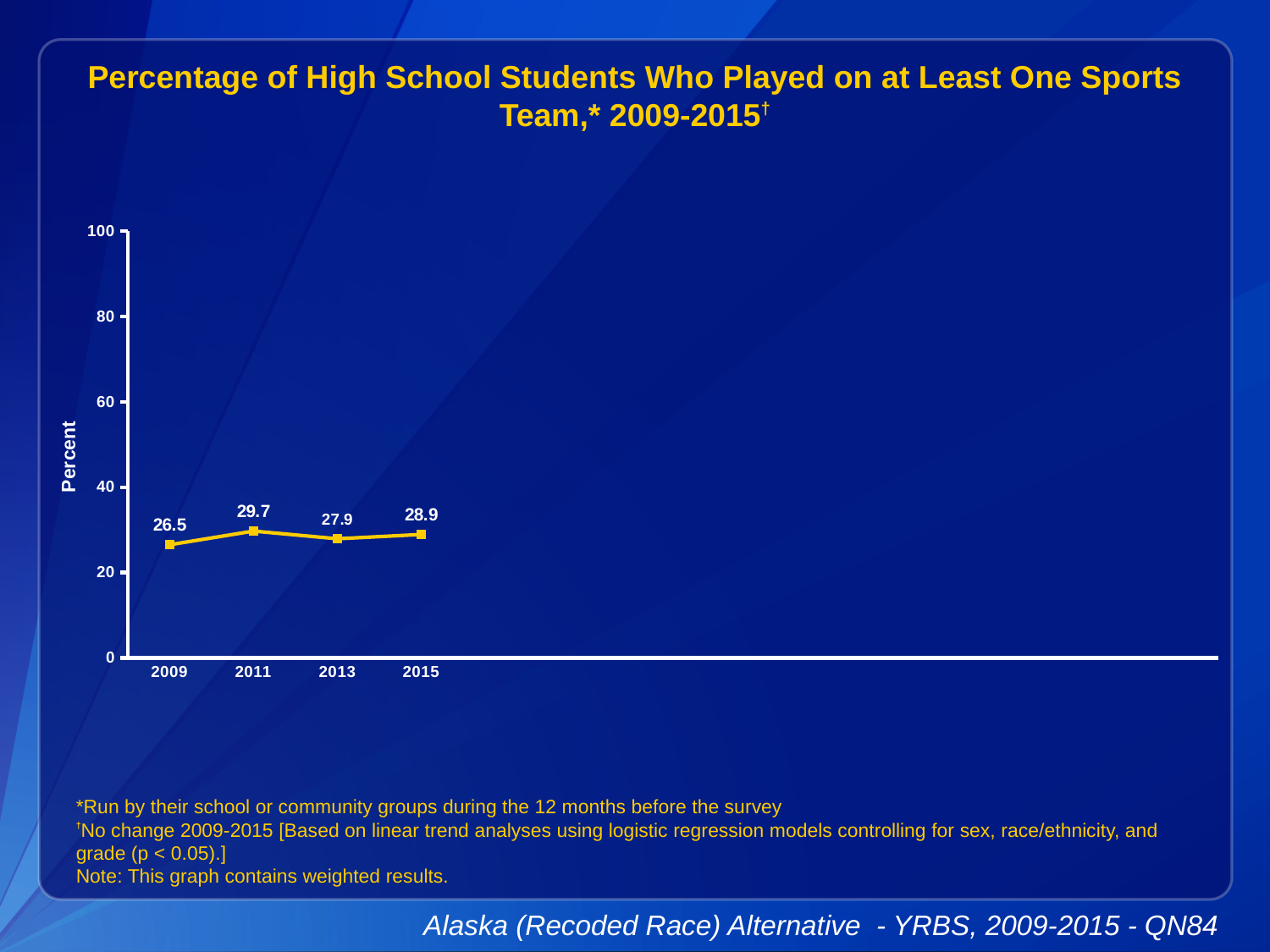
What is the value plotted for 2013? 27.9 Which year has the highest percentage? 2011 What is the label on the y axis? Percent What kind of chart is shown on the slide? line chart Is the value for 2011 greater or less than 40? less Which year has the lowest percentage? 2009 Which is larger, the value for 2013 or the value for 2015? 2015 What is the value plotted for 2011? 29.7 What is the value plotted for 2015? 28.9 What is the difference between the 2011 value and the 2009 value? 3.2 What percentage of high school students played on at least one sports team in 2009? 26.5 How many years are plotted on the chart? 4